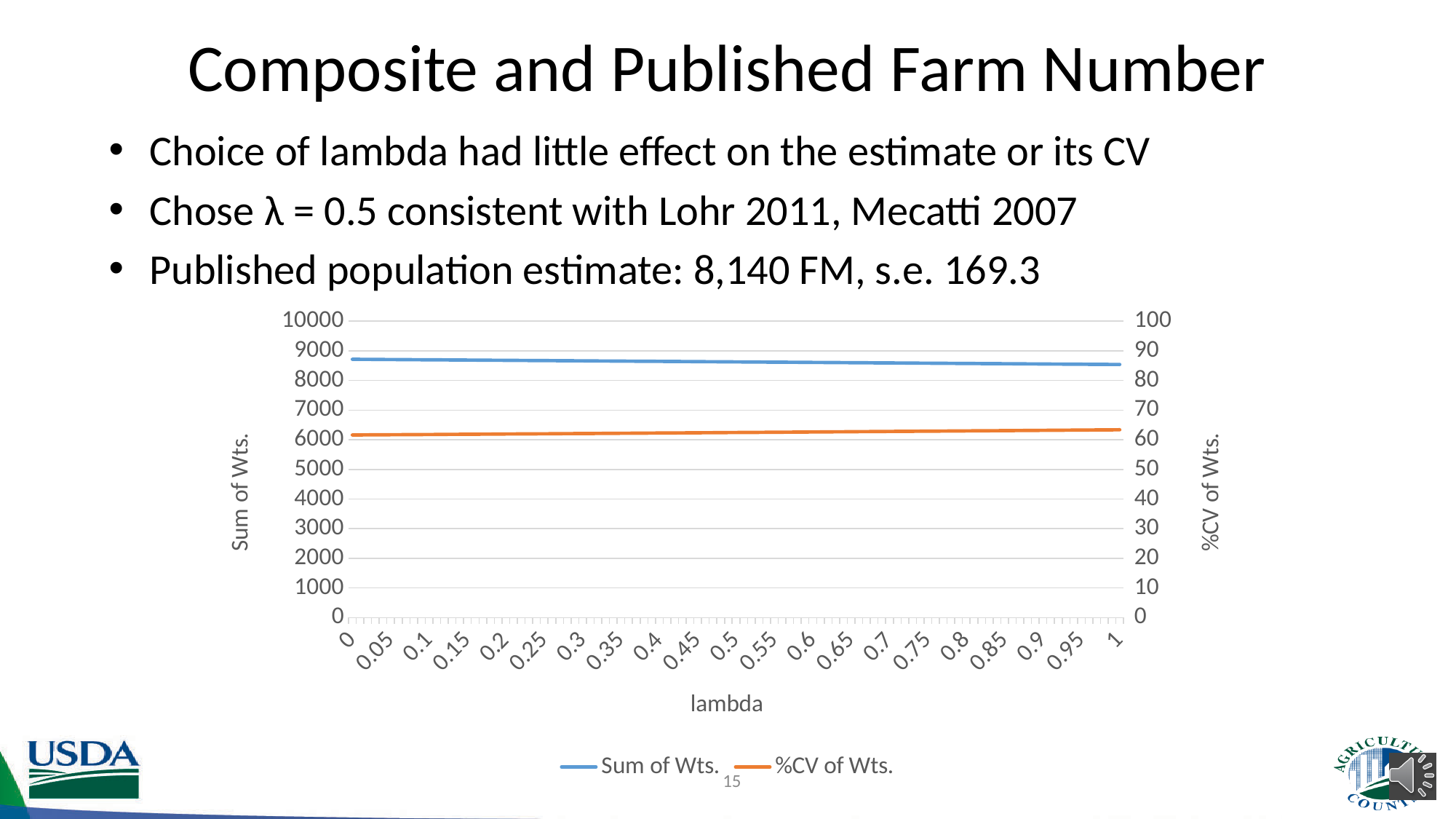
Does the %CV of Wts. line rise or fall as lambda increases from 0 to 1? rise Which series is plotted in orange in the chart? %CV of Wts. Is the Sum of Wts. value at lambda = 1 greater or less than 9000? less Is the %CV of Wts. value at lambda = 0.5 greater or less than 50 on the right axis? greater How many series does the chart's legend list? 2 What is the title of the x axis of the chart? lambda Does the Sum of Wts. line rise or fall as lambda increases from 0 to 1? fall Is the Sum of Wts. value at lambda = 0 greater or less than 8000? greater What kind of chart is shown on the slide? line chart What is the title of the left vertical axis of the chart? Sum of Wts. How many lambda values are marked along the x axis of the chart? 21